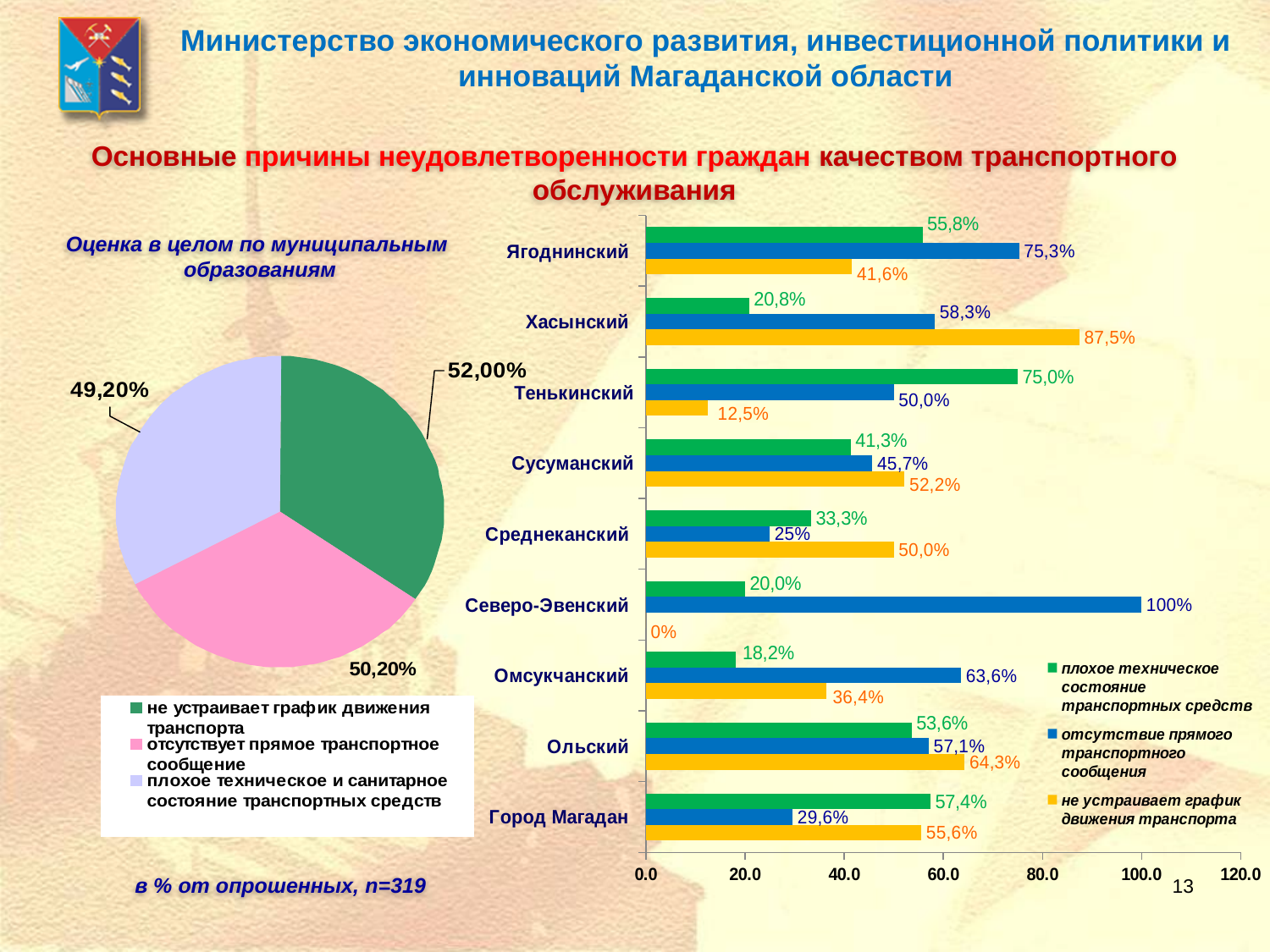
In the bar chart on the right, which municipality has the highest value for the series 'отсутствие прямого транспортного сообщения'? Северо-Эвенский In the bar chart on the right, which municipality has the lowest value for the series 'не устраивает график движения транспорта'? Северо-Эвенский In the pie chart on the left, what is the value for 'отсутствует прямое транспортное сообщение'? 50,20% In the bar chart on the right, which is larger for Омсукчанский: 'отсутствие прямого транспортного сообщения' or 'не устраивает график движения транспорта'? отсутствие прямого транспортного сообщения What kind of chart is the chart on the left of the slide? Pie chart In the bar chart on the right, what is the value for Тенькинский for the series 'плохое техническое состояние транспортных средств'? 75,0% In the pie chart on the left, which category has the highest value? не устраивает график движения транспорта In the bar chart on the right, what is the value for Хасынский for the series 'не устраивает график движения транспорта'? 87,5% In the bar chart on the right, what is the value for Город Магадан for the series 'отсутствие прямого транспортного сообщения'? 29,6% How many series does the legend of the bar chart on the right list? 3 In the bar chart on the right, what is the difference between the 'не устраивает график движения транспорта' value and the 'плохое техническое состояние транспортных средств' value for Хасынский? 66,7 percentage points How many municipalities are shown in the bar chart on the right? 9